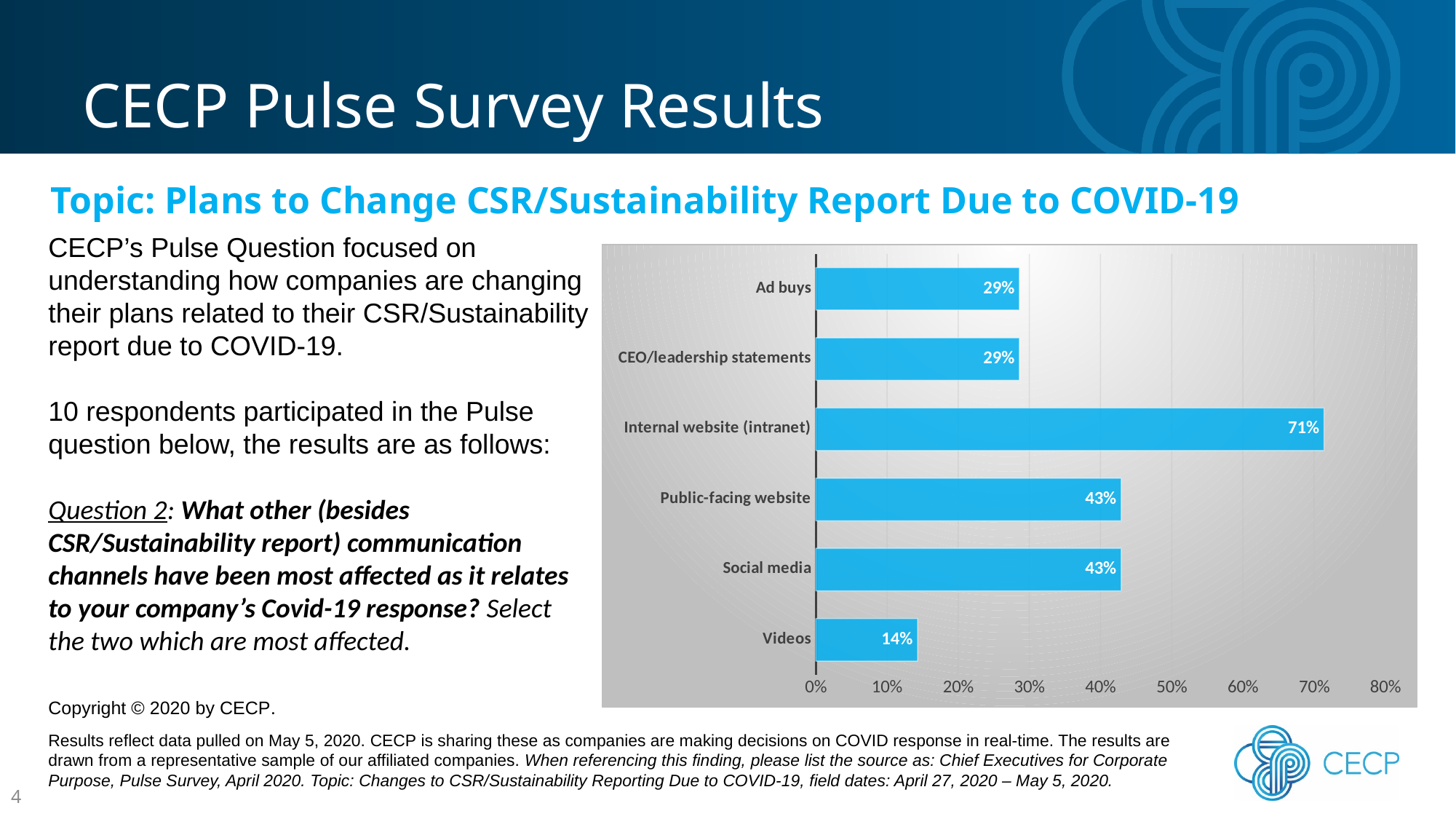
Which is larger, the value for Social media or the value for Ad buys? Social media What is the difference between the values for CEO/leadership statements and Videos? 15% What is the value for Ad buys? 29% Which category has the lowest value? Videos How many categories are shown in the chart? 6 What is the value for Public-facing website? 43% Which category has the highest value? Internal website (intranet) What is the value for Internal website (intranet)? 71% What is the value for Videos? 14% What kind of chart is shown on the slide? Bar chart Is the value for Internal website (intranet) greater or less than 60%? greater What is the difference between the values for Internal website (intranet) and Social media? 28%